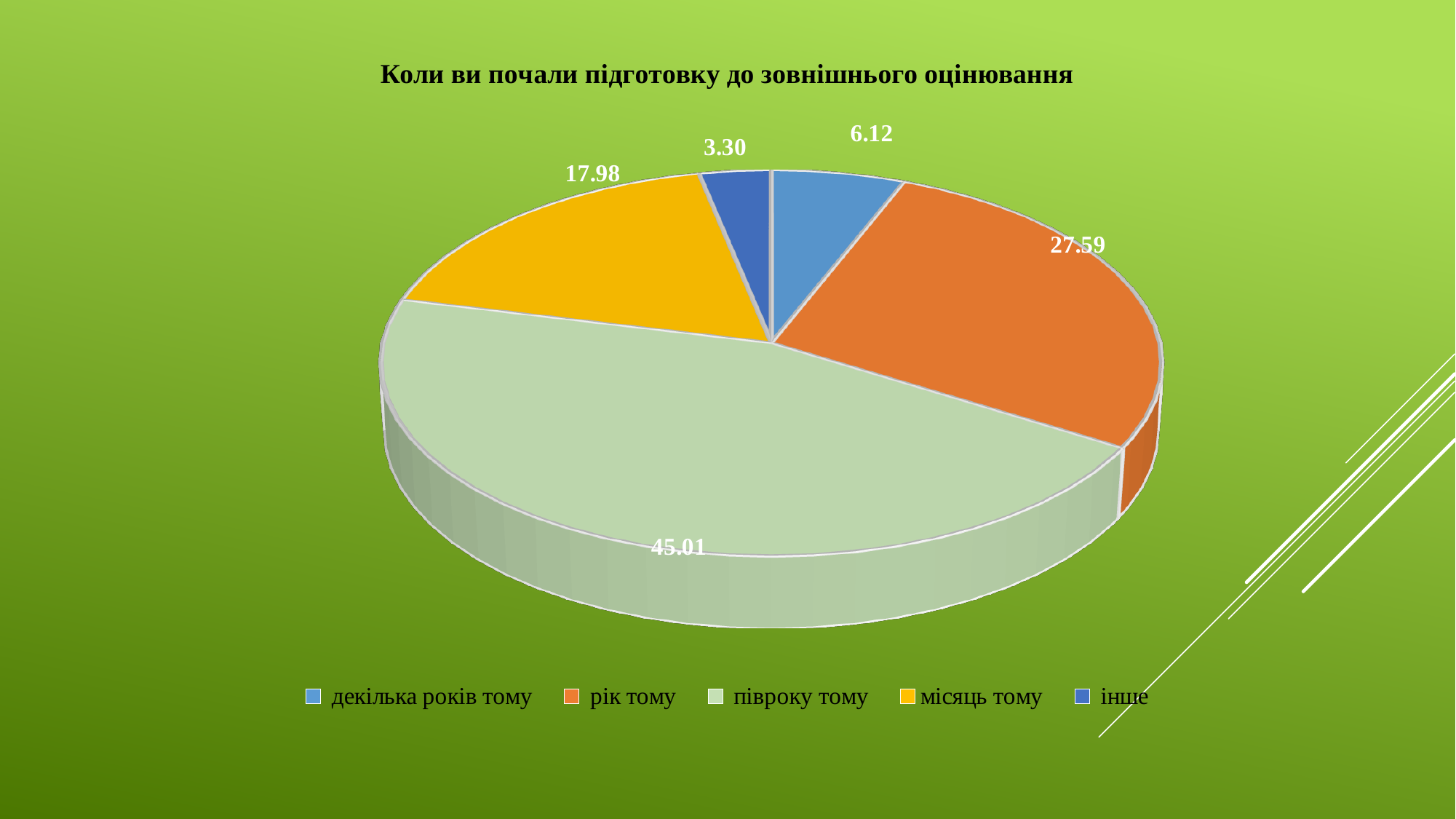
What is the value for "інше"? 3.30 How many categories does the legend list? 5 What is the difference between the values for "півроку тому" and "рік тому"? 17.42 Which is larger, the value for "місяць тому" or the value for "декілька років тому"? місяць тому What is the value for "рік тому"? 27.59 Which category has the smallest slice? інше What is the value for "місяць тому"? 17.98 Which category has the largest slice? півроку тому What is the title of the chart? Коли ви почали підготовку до зовнішнього оцінювання What is the value for "півроку тому"? 45.01 What is the value for "декілька років тому"? 6.12 What type of chart is shown on the slide? pie chart